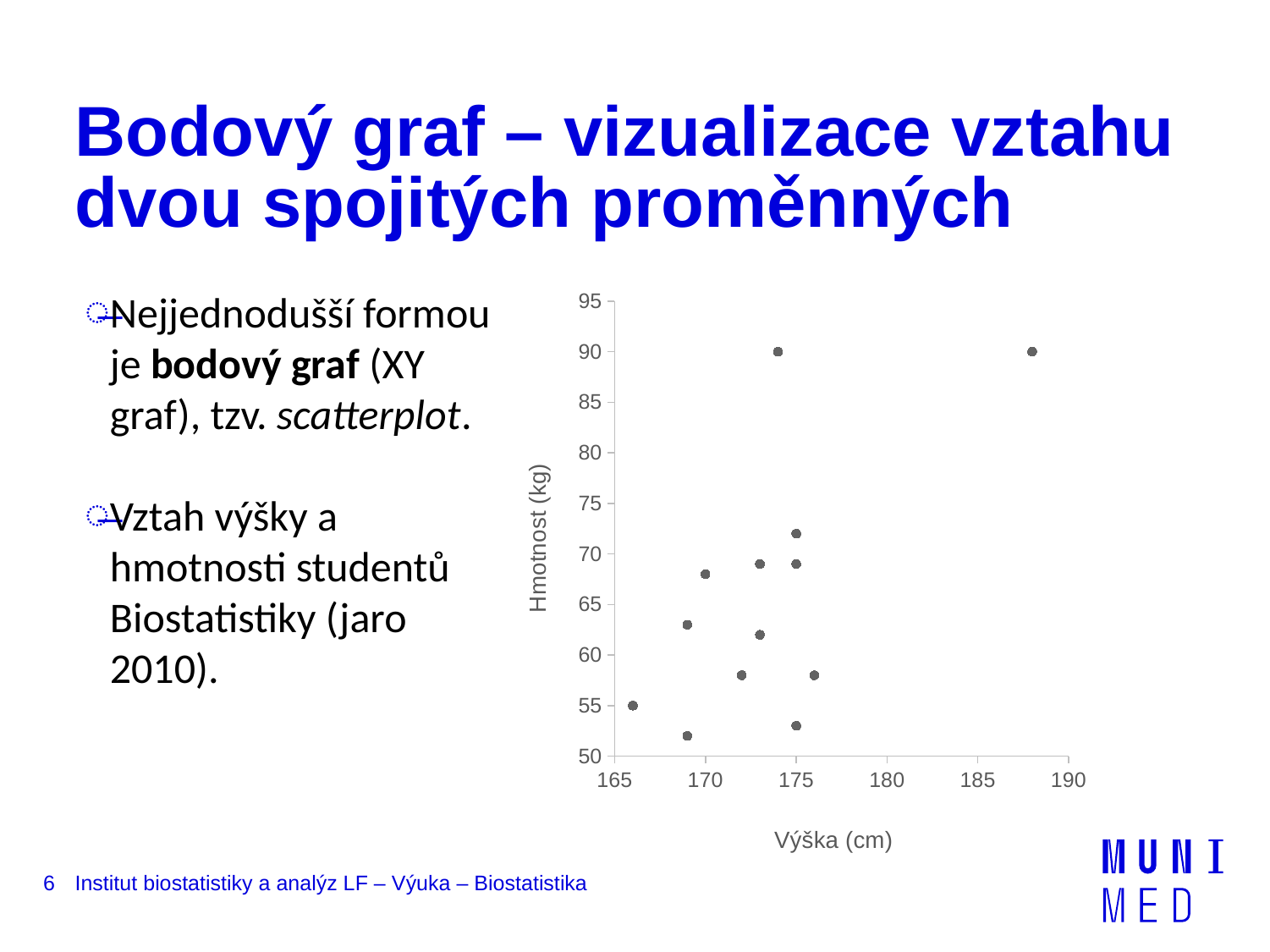
What kind of chart is shown on the slide? scatter plot What is the highest tick value shown on the vertical axis? 95 Is the height of the leftmost point greater or less than 170? less Is the weight of the point at 172 cm greater or less than 60? less What is the label of the horizontal axis of the chart? Výška (cm) Is the weight of the point at 170 cm greater or less than 65? greater How many data points are plotted in the chart? 13 Which point has the greater weight: the one at 166 cm or the one at 176 cm? the one at 176 cm Which point has the greater weight: the one at 170 cm or the one at 172 cm? the one at 170 cm What is the label of the vertical axis of the chart? Hmotnost (kg)